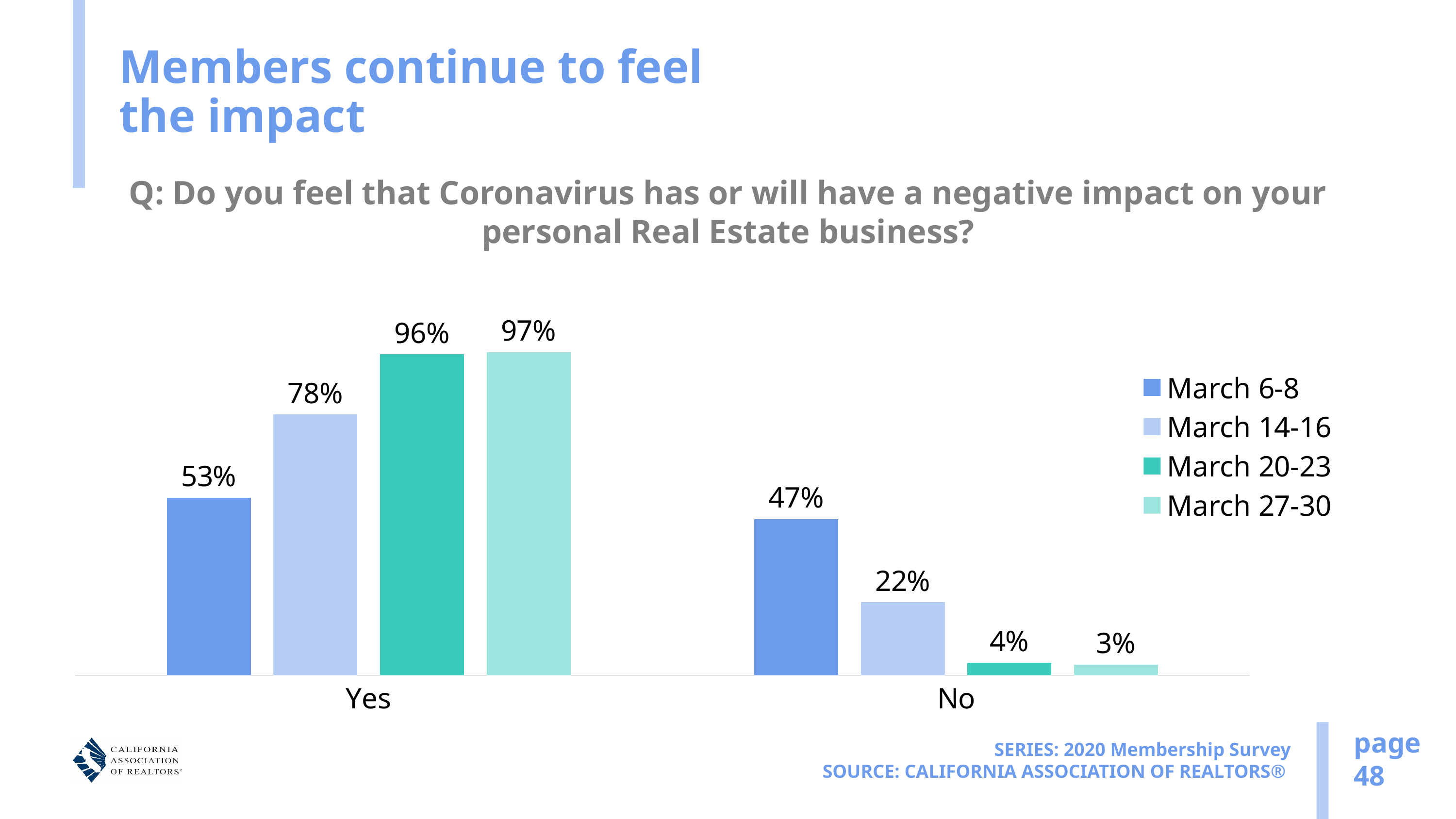
What percentage of members answered Yes in the March 6-8 survey? 53% What is the difference between the Yes values for March 14-16 and March 6-8? 25% Which survey period has the lowest No value? March 27-30 What is the Yes value for the March 27-30 survey? 97% Which survey period has the highest Yes value? March 27-30 How many response categories are shown on the x axis? 2 Do the Yes values rise or fall across the survey periods from March 6-8 to March 27-30? Rise What is the difference between the No values for March 6-8 and March 20-23? 43% What kind of chart is shown on the slide? Bar chart What percentage of members answered No in the March 14-16 survey? 22% Which is larger: the Yes value for March 20-23 or the Yes value for March 14-16? March 20-23 How many survey periods does the legend list? 4